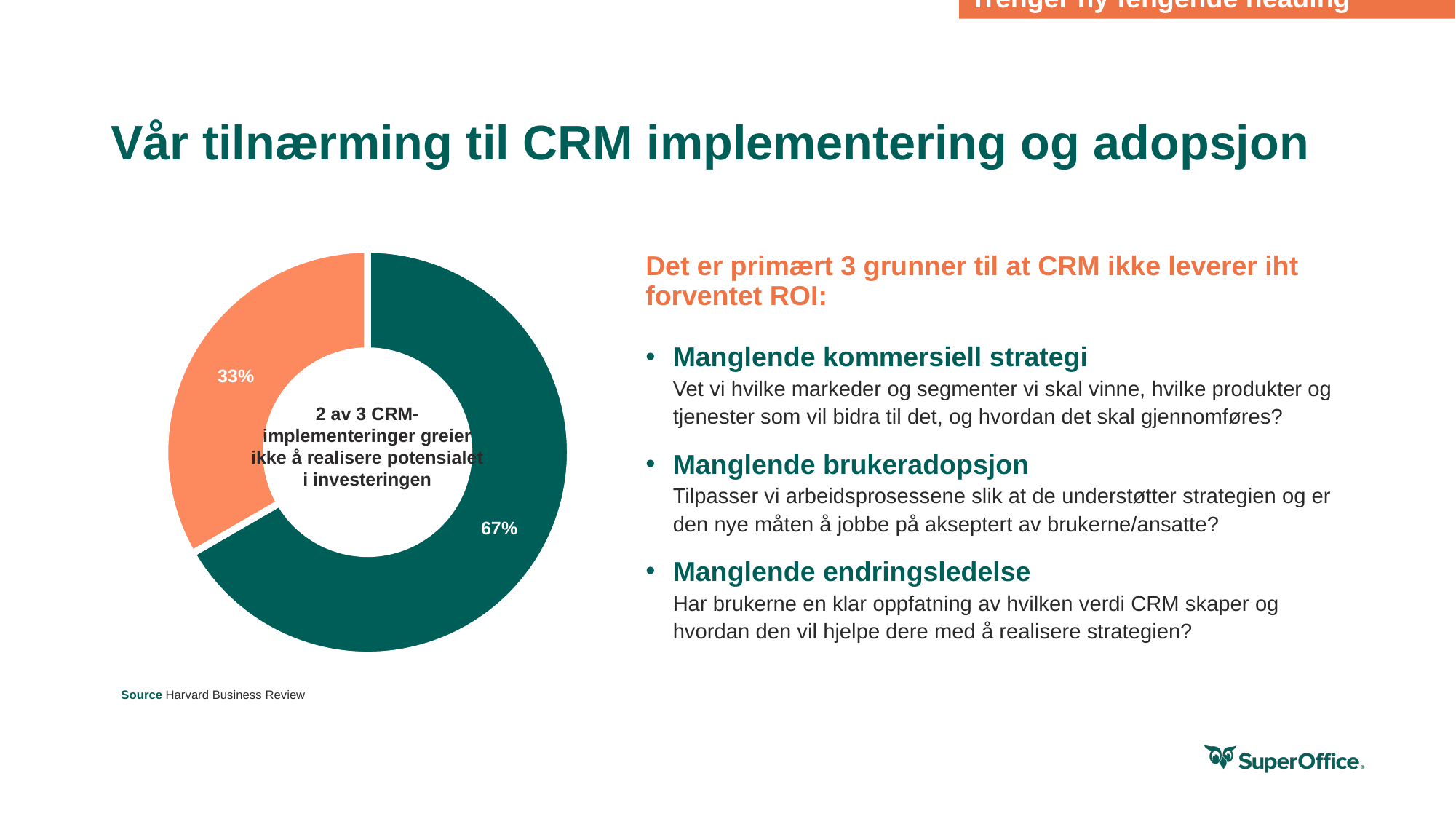
What percentage is shown on the dark teal slice of the donut chart? 67% Which slice is larger, the dark teal one or the orange one? The dark teal one What is the value of the largest slice in the donut chart? 67% How many slices does the donut chart have? 2 What is the difference in percentage points between the two slices of the donut chart? 34 percentage points What text is written in the centre of the donut chart? 2 av 3 CRM-implementeringer greier ikke å realisere potensialet i investeringen What is the value of the smallest slice in the donut chart? 33% What do the two slices of the donut chart add up to? 100% Is the value of the orange slice greater or less than 50%? less What percentage is shown on the orange slice of the donut chart? 33% What source is cited below the donut chart? Harvard Business Review What kind of chart is shown on the slide? Pie chart (donut)